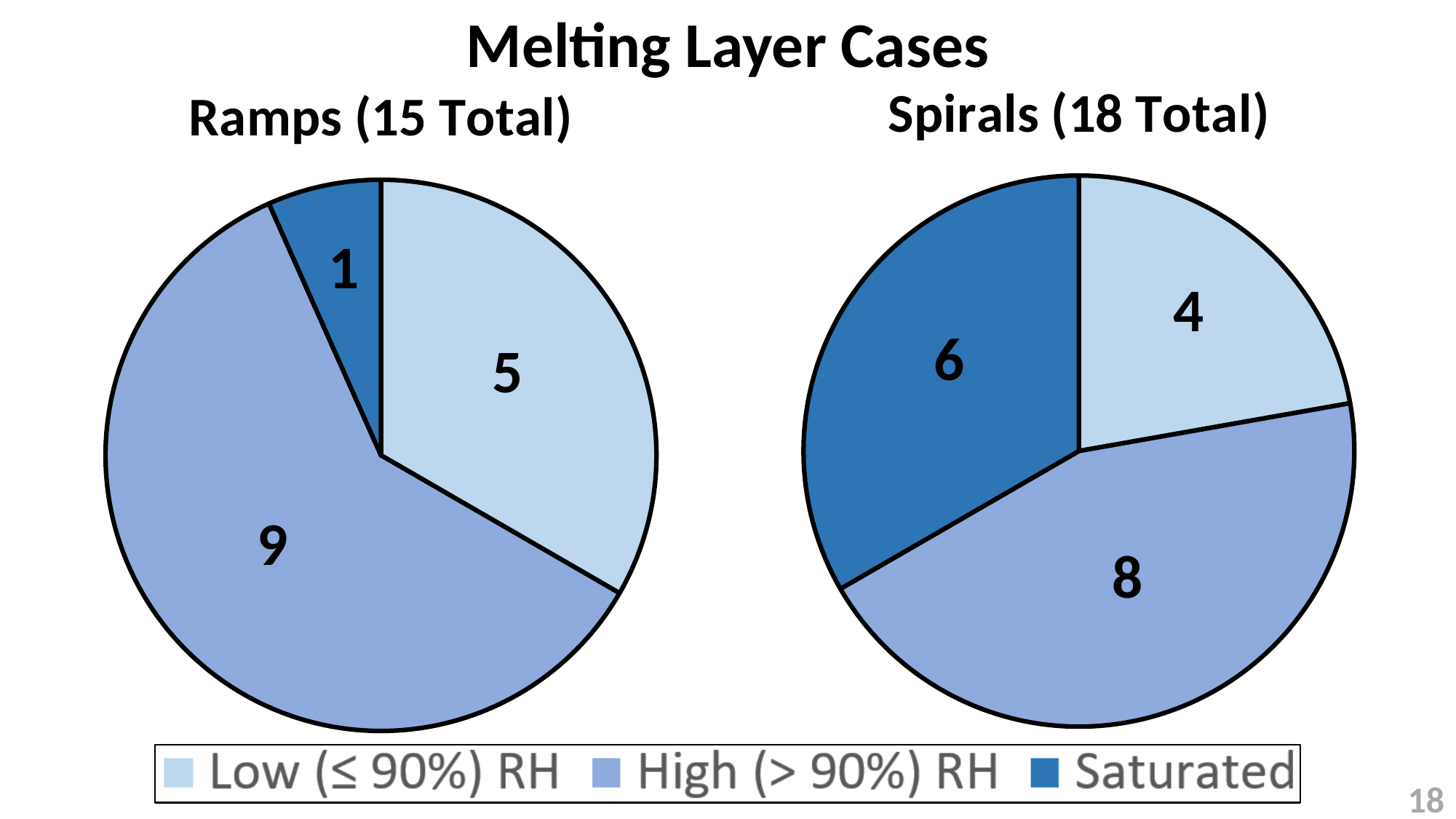
How many entries does the legend list? 3 What type of chart is used for Ramps (15 Total)? Pie chart Which is larger: the Saturated value in the Ramps chart or the Saturated value in the Spirals chart? Spirals In the Ramps (15 Total) pie chart, what is the value for Low (≤ 90%) RH? 5 How many slices does the Spirals (18 Total) pie chart have? 3 What is the overall title above the two charts? Melting Layer Cases In the Spirals (18 Total) pie chart, what is the value for Saturated? 6 In the Ramps (15 Total) pie chart, which category has the smallest slice? Saturated In the Spirals (18 Total) pie chart, what is the difference between the High (> 90%) RH and Saturated values? 2 In the Ramps (15 Total) pie chart, what is the difference between the High (> 90%) RH and Low (≤ 90%) RH values? 4 In the Spirals (18 Total) pie chart, which category has the largest slice? High (> 90%) RH In the Ramps (15 Total) pie chart, what is the value for High (> 90%) RH? 9